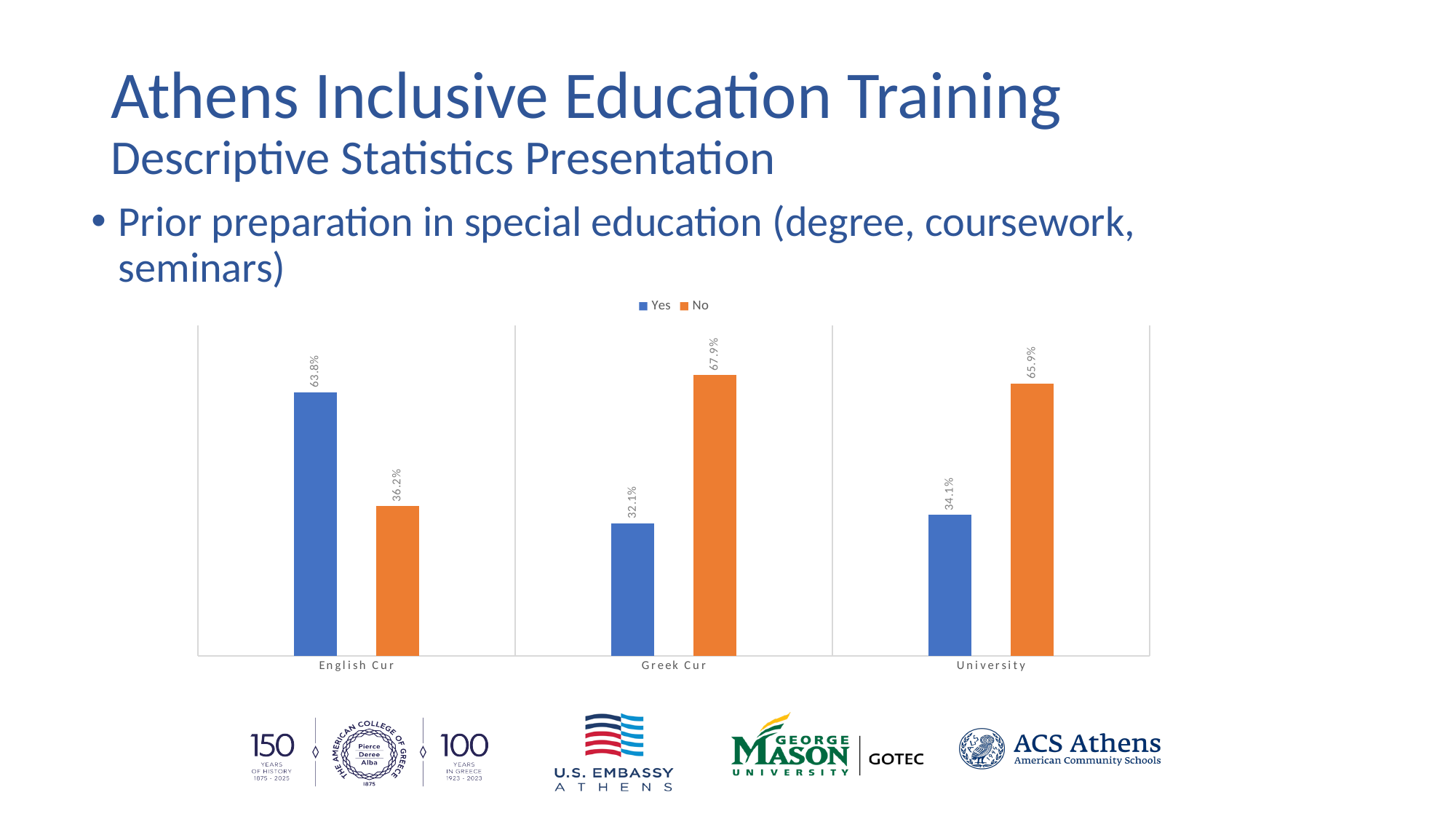
Which category has the lowest Yes value? Greek Cur What is the value of the Yes bar for University? 34.1% Which is larger for University, the Yes value or the No value? No Which colour represents the No series in the chart? Orange How many series does the legend list? 2 What is the value of the Yes bar for English Cur? 63.8% What is the value of the No bar for Greek Cur? 67.9% What is the difference between the No and Yes values for Greek Cur? 35.8% How many categories are shown on the x axis? 3 What is the value of the No bar for English Cur? 36.2% Which category has the highest Yes value? English Cur What kind of chart is shown on the slide? Bar chart